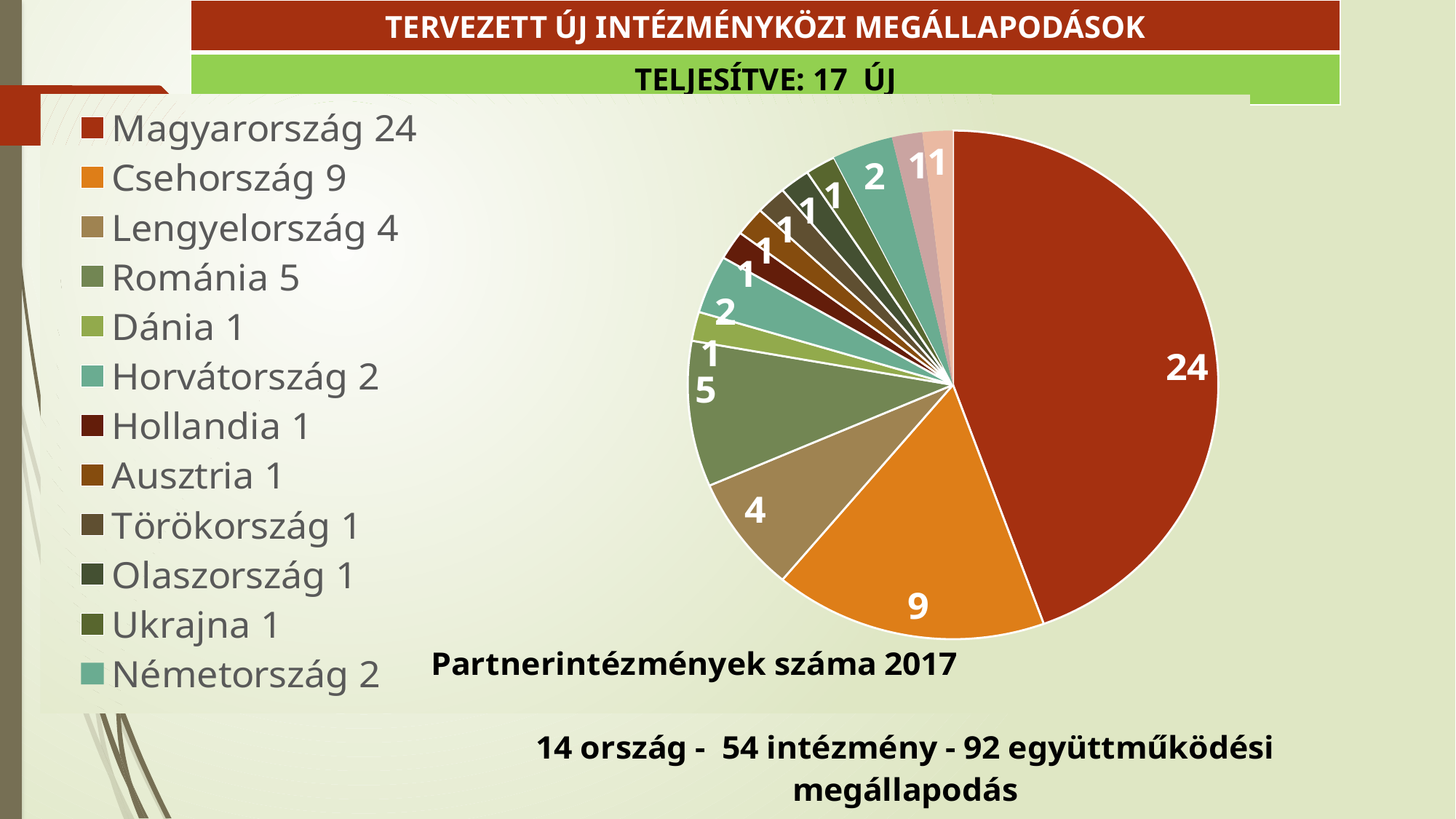
What value is shown for Csehország in the pie chart? 9 Which is larger, the value for Románia or the value for Lengyelország? Románia How many entries does the legend of the pie chart list? 12 What value is shown for Horvátország in the pie chart? 2 What value is shown for Magyarország in the pie chart? 24 What is the difference between the values for Magyarország and Csehország? 15 What kind of chart is shown on the slide? Pie chart What is the difference between the values for Csehország and Románia? 4 Which country has the largest slice in the pie chart? Magyarország What value is shown for Románia in the pie chart? 5 What value is shown for Lengyelország in the pie chart? 4 What is the title of the pie chart? Partnerintézmények száma 2017